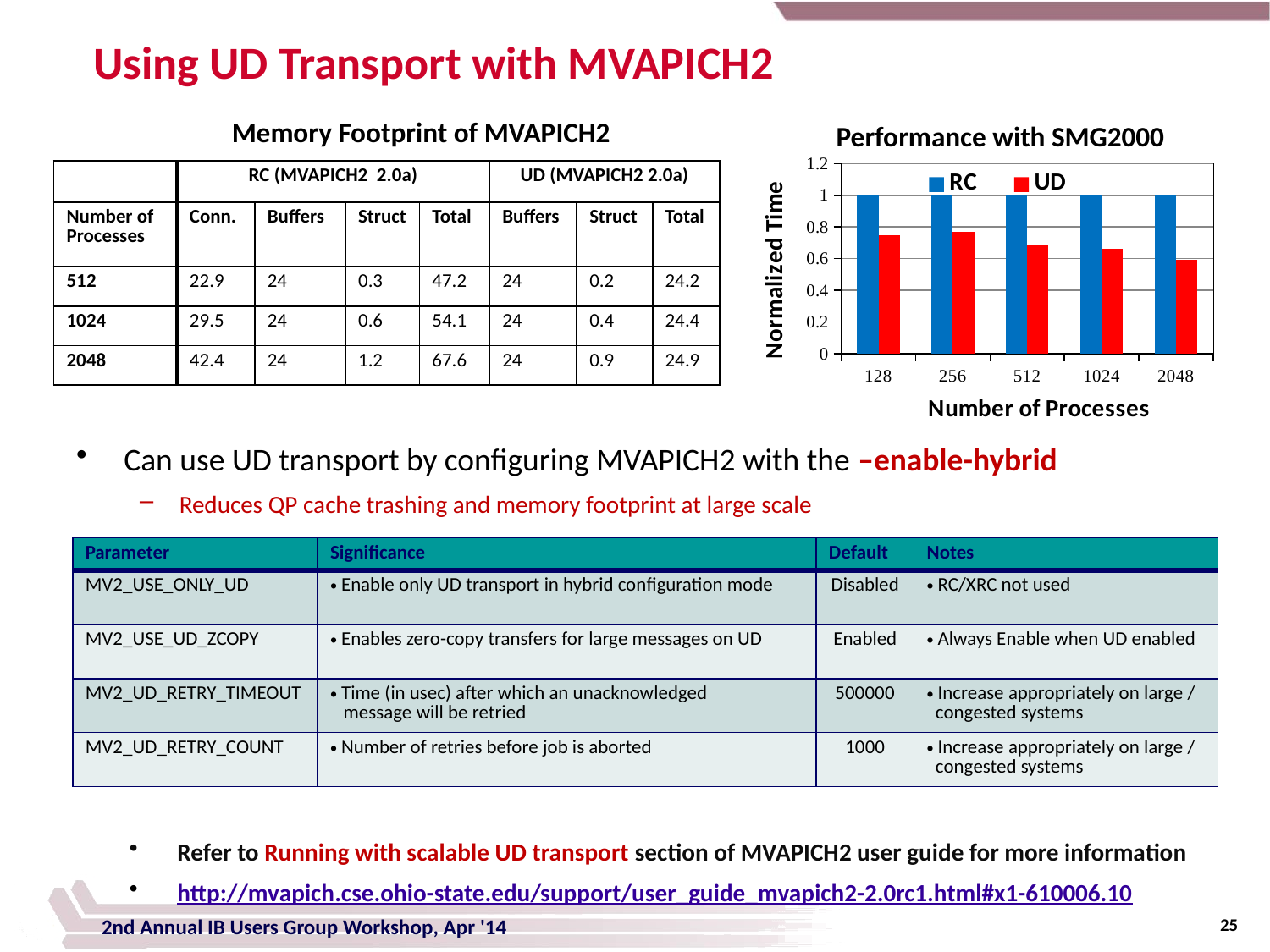
In the "Performance with SMG2000" chart, is the UD value at 512 processes greater or less than 0.8? less In the "Performance with SMG2000" chart, at which number of processes is the UD value lowest? 2048 What is the label of the y axis in the "Performance with SMG2000" chart? Normalized Time In the "Performance with SMG2000" chart, is the UD value at 2048 processes greater or less than 0.8? less In the "Performance with SMG2000" chart, what is the normalized time for RC at 512 processes? 1 How many series does the legend of the "Performance with SMG2000" chart list? 2 What type of chart is shown under the title "Performance with SMG2000"? bar chart In the "Performance with SMG2000" chart, which series has the larger value at 1024 processes, RC or UD? RC How many process counts are shown on the x axis of the "Performance with SMG2000" chart? 5 In the "Performance with SMG2000" chart, what is the normalized time for RC at 2048 processes? 1 In the "Performance with SMG2000" chart, is the UD value larger at 128 processes or at 2048 processes? 128 In the "Performance with SMG2000" chart, is the UD value at 128 processes greater or less than 0.6? greater